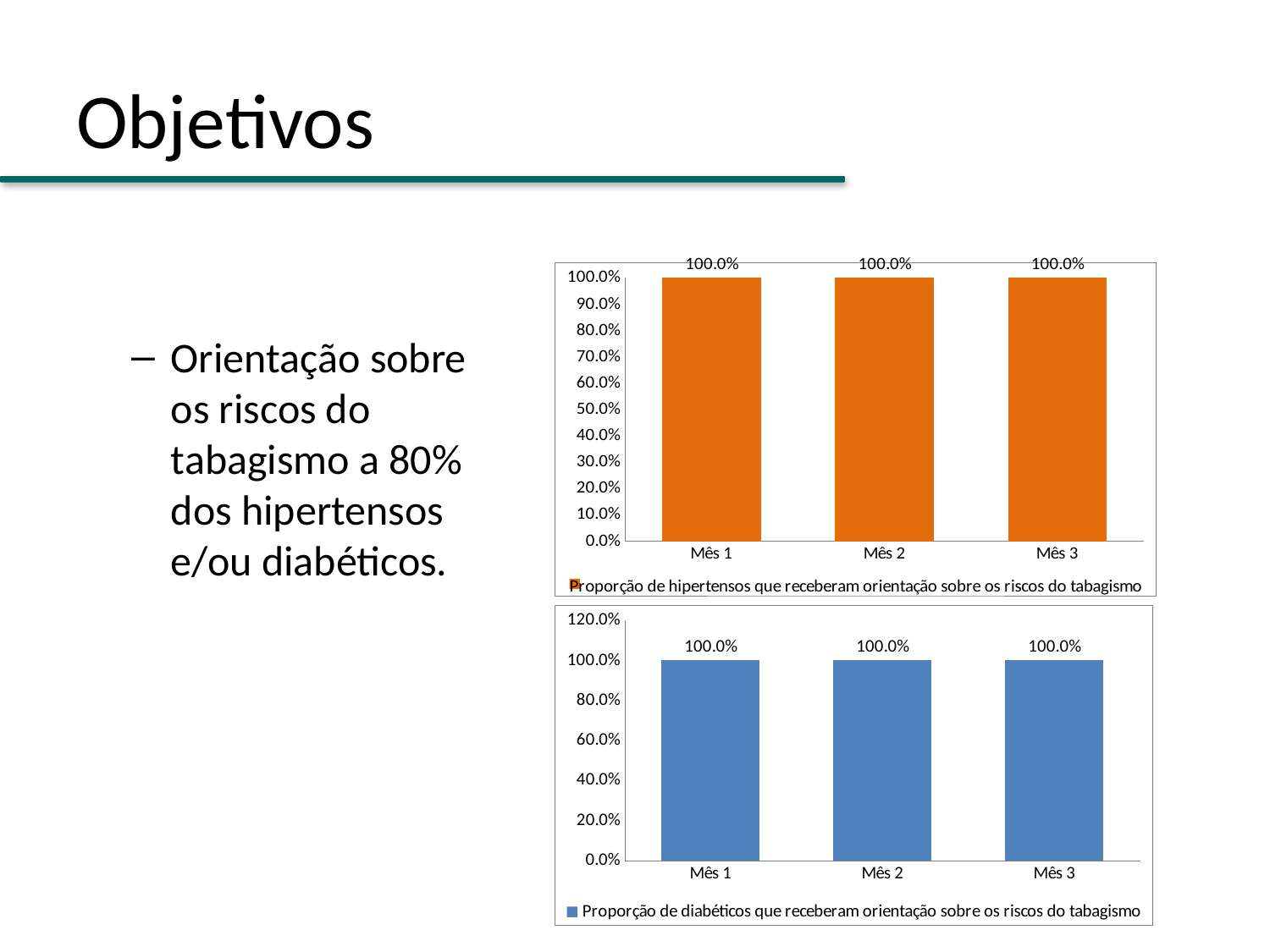
What colour are the bars in the bottom chart? blue In the bottom chart, what is the value for Mês 2? 100.0% What kind of chart is the bottom chart? bar chart In the top chart, what is the value for Mês 3? 100.0% What is the legend entry of the top chart? Proporção de hipertensos que receberam orientação sobre os riscos do tabagismo In the bottom chart, what is the value for Mês 3? 100.0% How many series does the legend of the bottom chart list? 1 How many categories are shown on the x axis of the top chart? 3 In the top chart, what is the value for Mês 1? 100.0% In the top chart, what is the difference between the values for Mês 1 and Mês 2? 0.0% In the bottom chart, is the value for Mês 1 greater or less than 80.0%? greater In the top chart, do the values rise, fall or stay the same from Mês 1 to Mês 3? stay the same